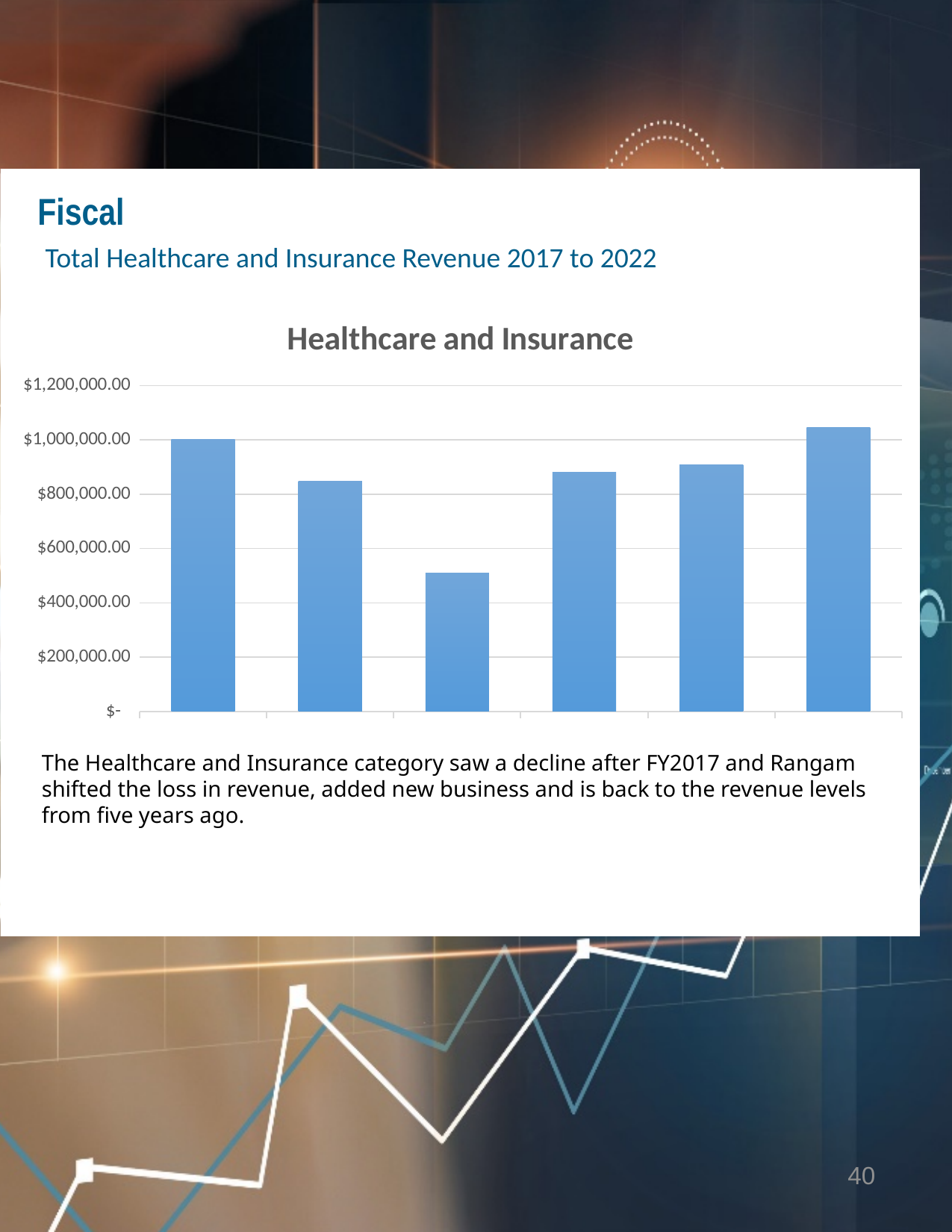
Which is larger, the first bar from the left or the second bar from the left? the first bar Is the value of the sixth bar from the left greater or less than $1,000,000.00? greater How many bars are plotted in the Healthcare and Insurance chart? 6 What is the title of the chart on the slide? Healthcare and Insurance What kind of chart is shown on the slide? bar chart Is the value of the fifth bar from the left greater or less than $800,000.00? greater Which bar in the Healthcare and Insurance chart is the tallest, counting from the left? the sixth bar Which bar in the Healthcare and Insurance chart is the shortest, counting from the left? the third bar Is the value of the second bar from the left greater or less than $1,000,000.00? less Which is larger, the third bar from the left or the fourth bar from the left? the fourth bar What is the highest value labelled on the vertical axis of the chart? $1,200,000.00